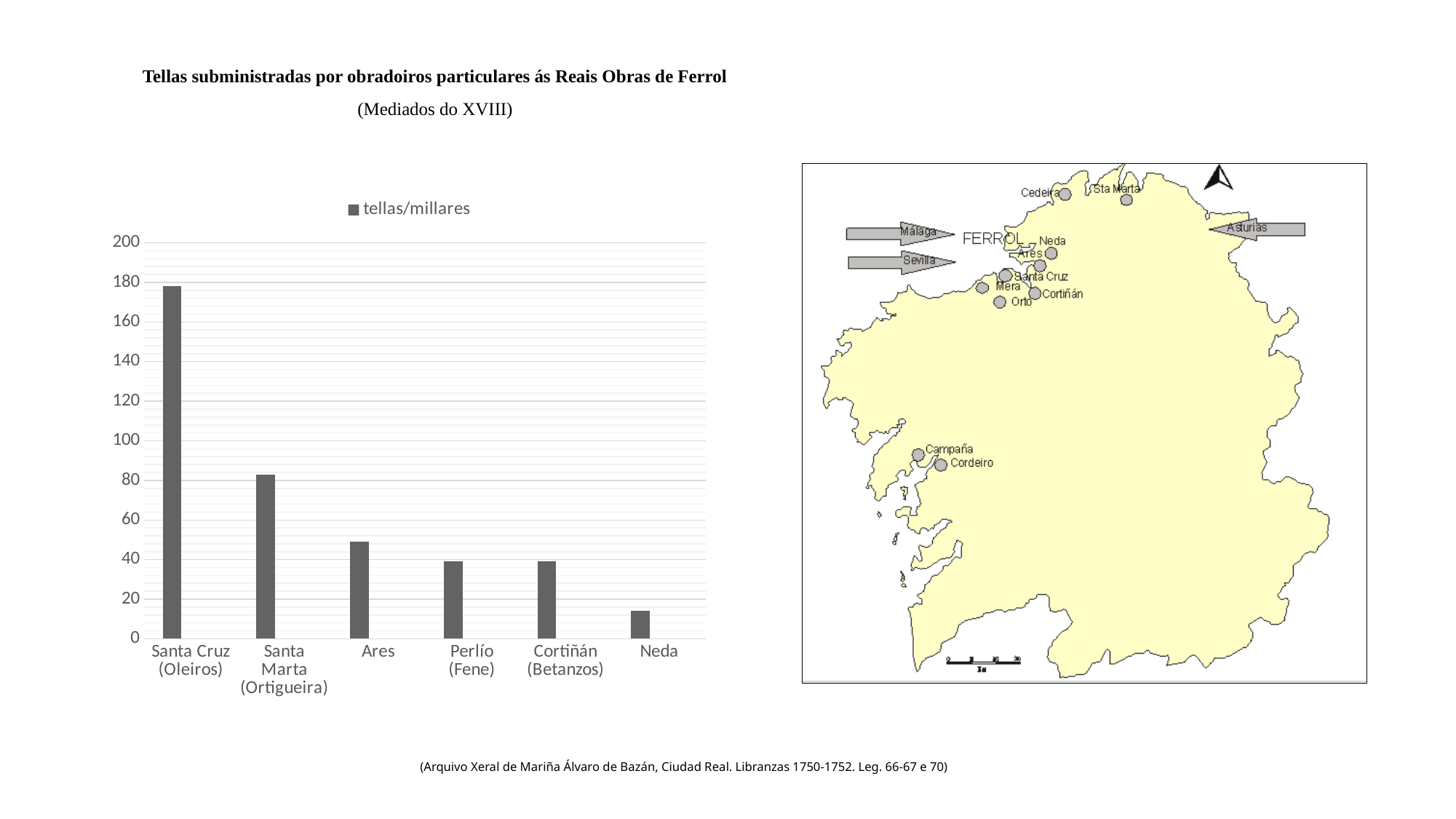
How many series does the legend of the bar chart list? 1 Which category has the highest value in the bar chart? Santa Cruz (Oleiros) Which is larger, the value for Santa Marta (Ortigueira) or the value for Ares? Santa Marta (Ortigueira) What kind of chart is shown on the slide? bar chart Do the values in the bar chart generally rise or fall from left to right along the x axis? fall Is the value for Neda greater or less than 20? less Which category has the lowest value in the bar chart? Neda Is the value for Santa Marta (Ortigueira) greater or less than 100? less What is the legend entry of the bar chart? tellas/millares How many categories are shown on the x axis of the bar chart? 6 Is the value for Santa Cruz (Oleiros) greater or less than 160? greater